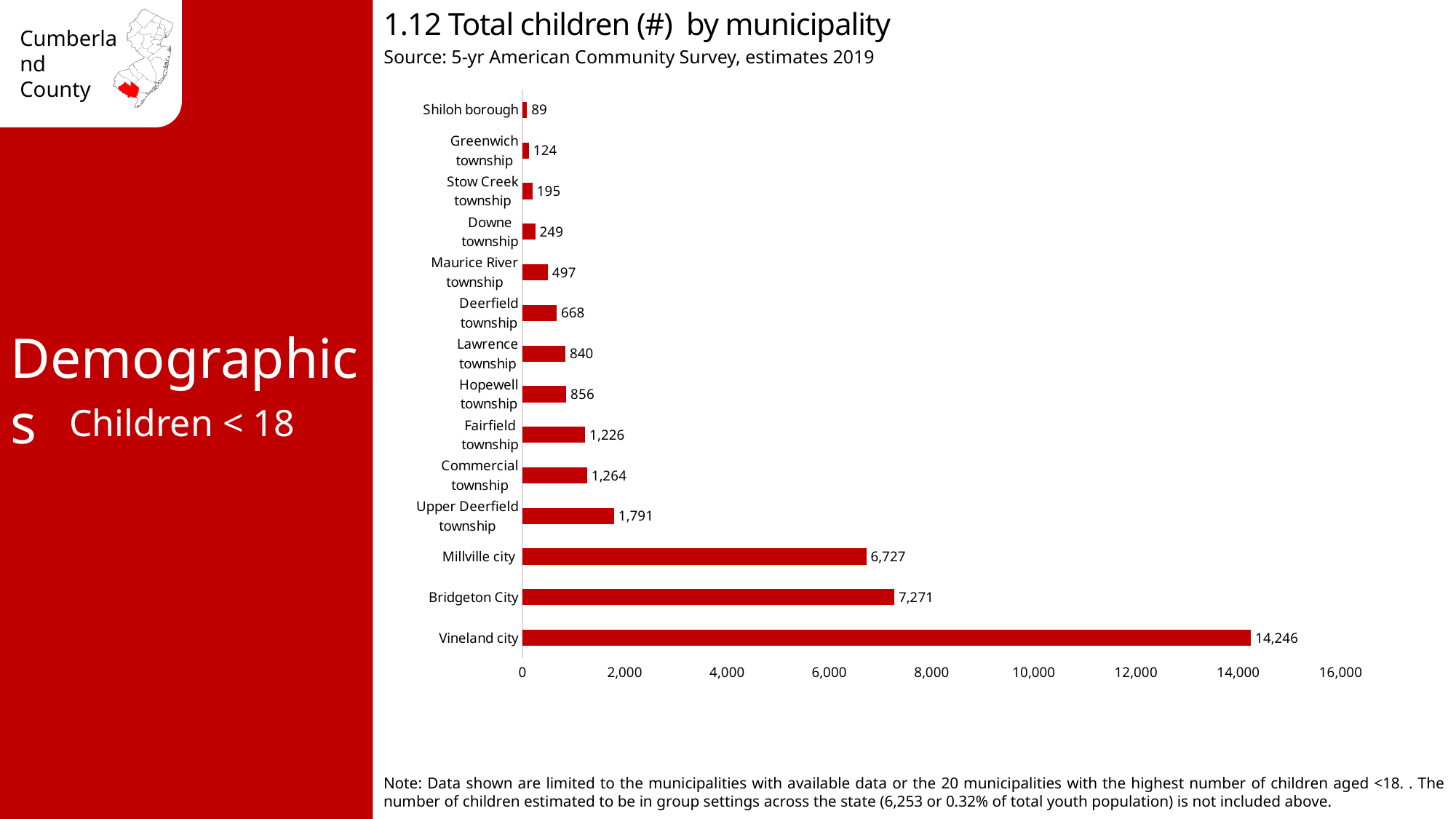
Which municipality has the highest number of children? Vineland city What is the difference in the number of children between Bridgeton City and Millville city? 544 What is the total number of children in Maurice River township? 497 What is the total number of children in Upper Deerfield township? 1,791 How many municipalities are shown in the chart? 14 Is the value for Millville city greater or less than 6,000? greater What kind of chart is shown on the slide? Bar chart What is the source of the data shown in the chart? 5-yr American Community Survey, estimates 2019 What is the difference in the number of children between Hopewell township and Lawrence township? 16 Which municipality has the lowest number of children? Shiloh borough What is the total number of children in Vineland city? 14,246 Which has more children, Fairfield township or Commercial township? Commercial township